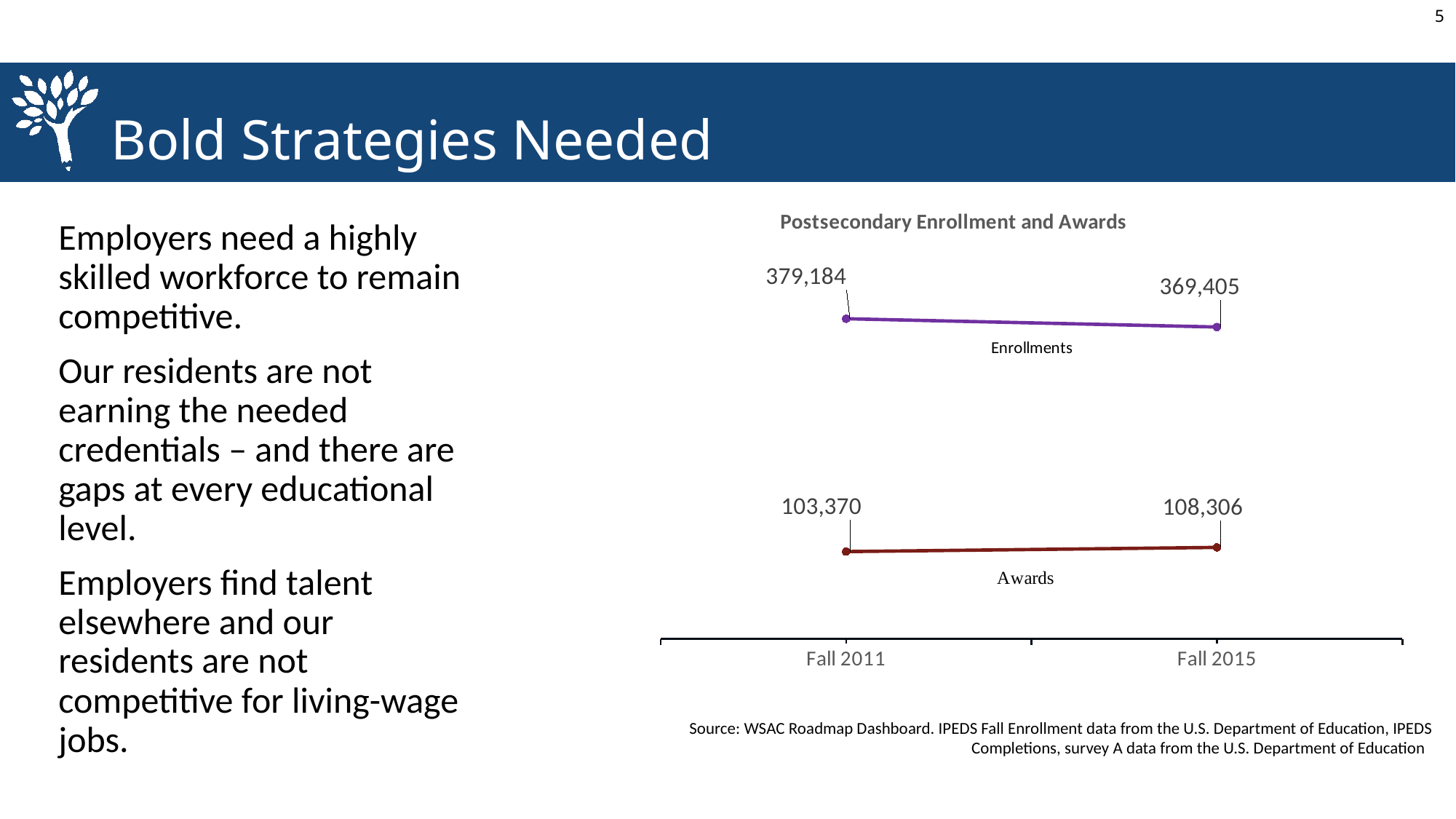
By how much did Enrollments change from Fall 2011 to Fall 2015? 9,779 Do Enrollments rise or fall from Fall 2011 to Fall 2015? fall Do Awards rise or fall from Fall 2011 to Fall 2015? rise By how much did Awards change from Fall 2011 to Fall 2015? 4,936 What is the title of the chart? Postsecondary Enrollment and Awards What is the value for Awards in Fall 2015? 108,306 What kind of chart is shown on the slide? line chart What is the value for Enrollments in Fall 2011? 379,184 How many series are plotted on the chart? 2 What is the value for Awards in Fall 2011? 103,370 Which is larger in Fall 2015, Enrollments or Awards? Enrollments What is the value for Enrollments in Fall 2015? 369,405